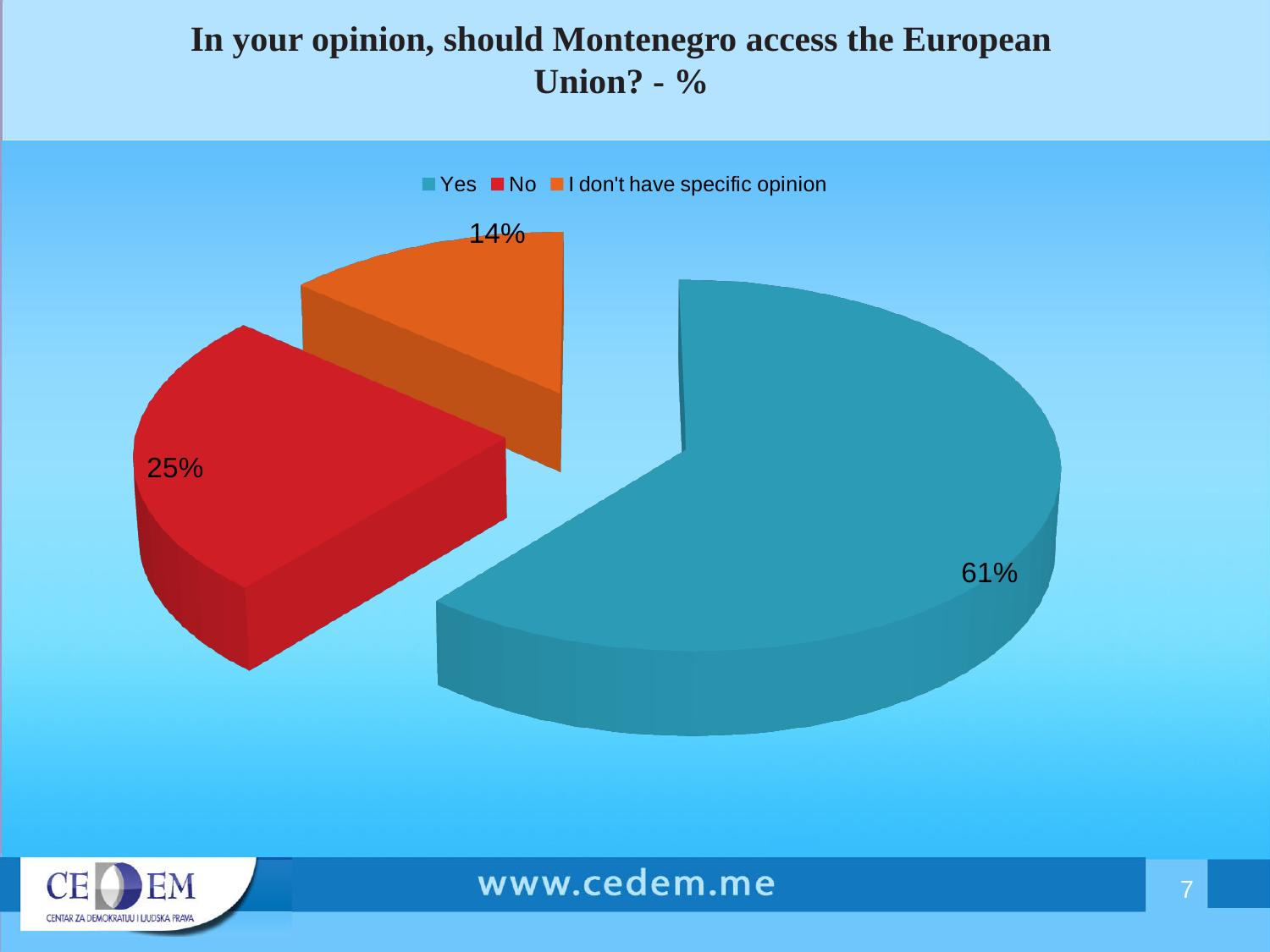
What percentage of respondents said "I don't have specific opinion"? 14% What colour is the "No" slice? Red How many entries does the legend list? 3 How many slices does the pie chart have? 3 What percentage of respondents answered "No"? 25% Which response has the smallest share of the pie? I don't have specific opinion What percentage of respondents answered "Yes"? 61% Which is larger, the share for "No" or the share for "I don't have specific opinion"? No What kind of chart is shown on the slide? Pie chart What is the difference in percentage points between "Yes" and "No"? 36 Which response has the largest share of the pie? Yes What is the difference in percentage points between "No" and "I don't have specific opinion"? 11